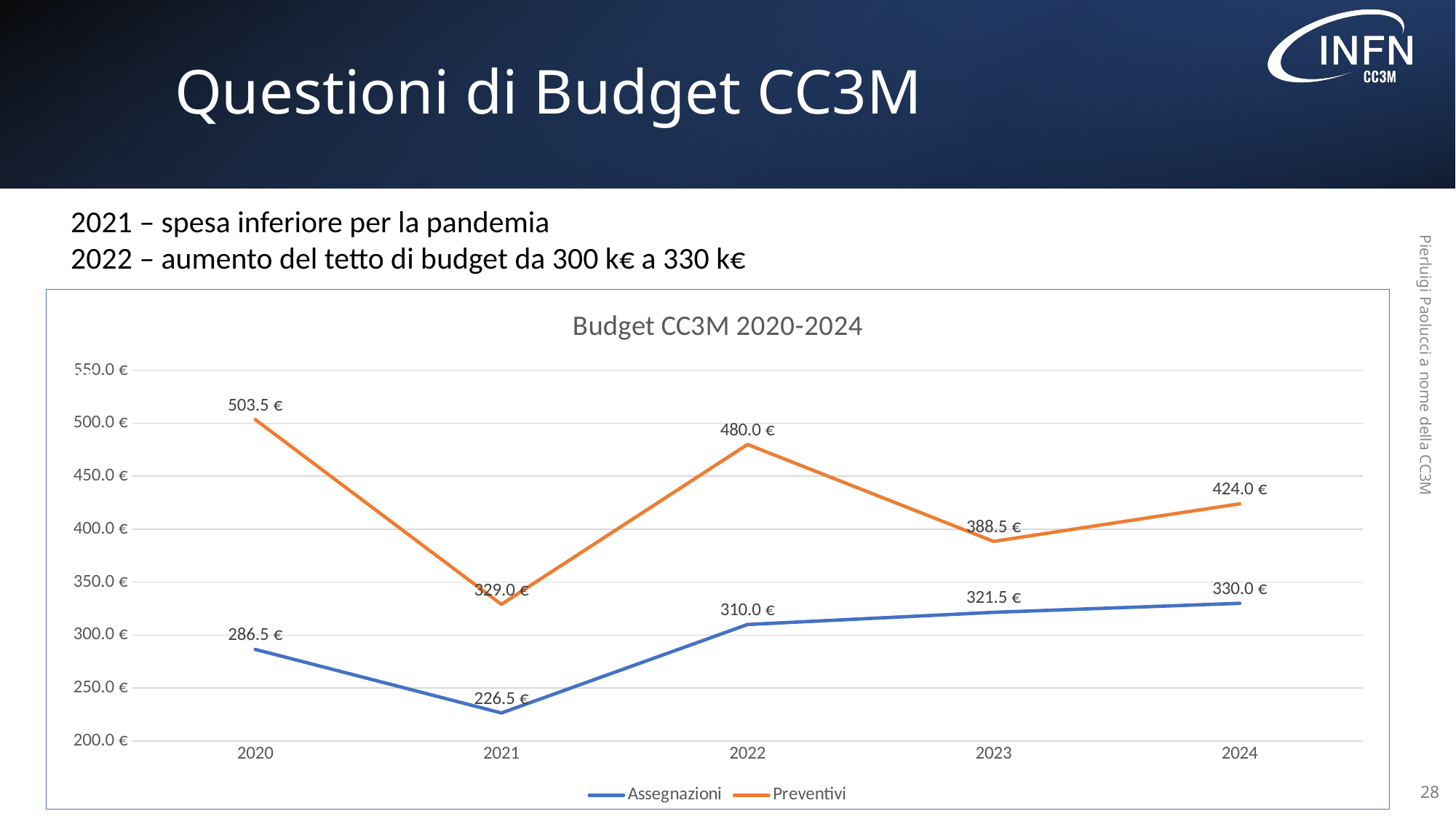
What is the value of Preventivi for 2020? 503.5 € Which is larger in 2021: Preventivi or Assegnazioni? Preventivi How many years are shown on the x axis? 5 What is the value of Assegnazioni for 2021? 226.5 € How many series does the legend list? 2 What is the value of Preventivi for 2023? 388.5 € What kind of chart is this? Line chart What is the difference between Preventivi and Assegnazioni in 2022? 170.0 € In which year is Preventivi highest? 2020 What is the value of Assegnazioni for 2024? 330.0 € Does Assegnazioni rise or fall from 2021 to 2024? Rise In which year is Assegnazioni lowest? 2021